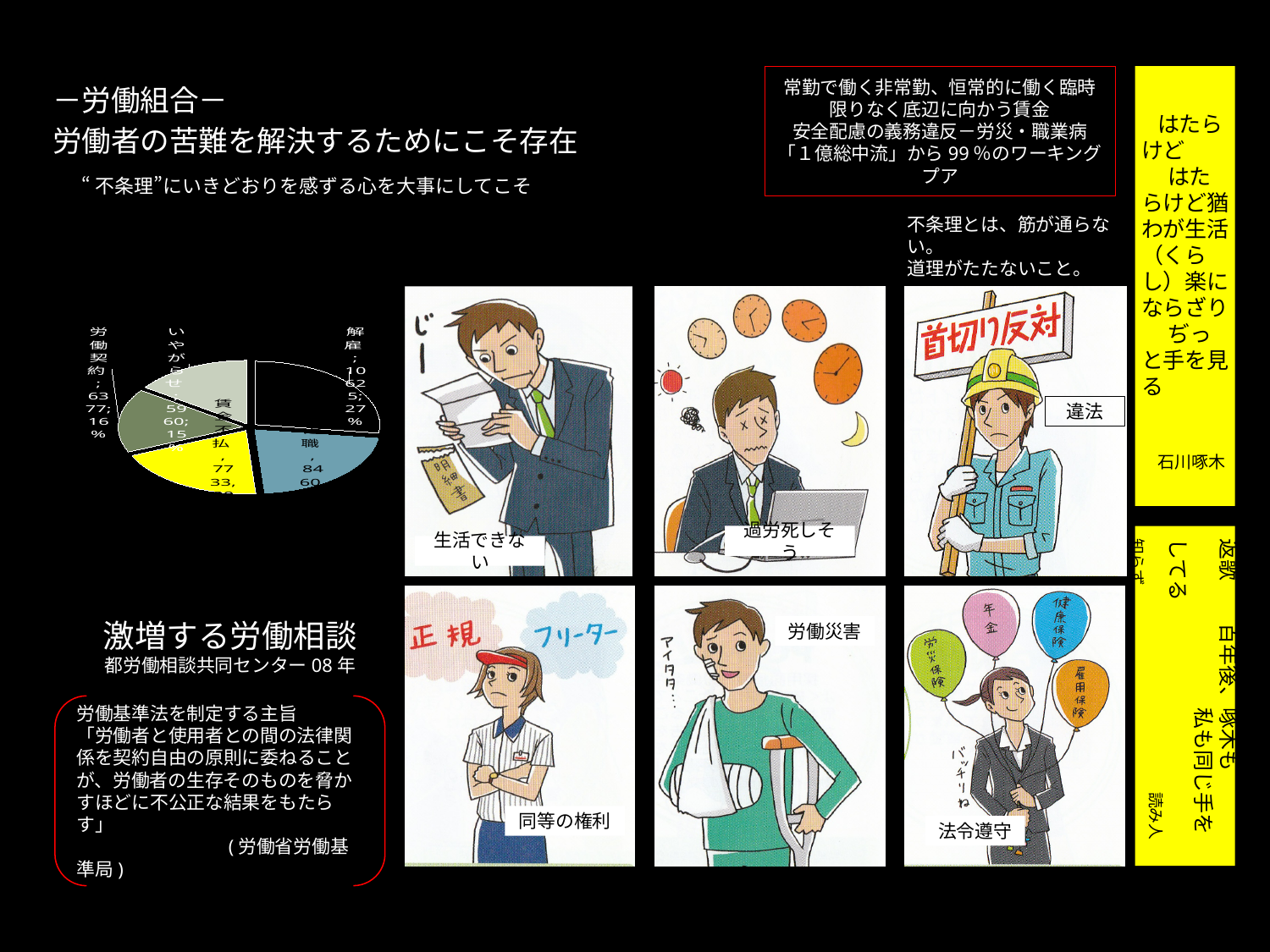
Which is larger in the pie chart, 解雇 or 労働契約? 解雇 In the pie chart, what share is labelled for 解雇? 27% In the pie chart, what share is labelled for 労働契約? 16% In the pie chart, what value is labelled for 労働契約? 6377 Which category has the largest slice in the pie chart? 解雇 What is the difference in percentage points between the 解雇 share and the 労働契約 share in the pie chart? 11 In the pie chart, what share is labelled for いやがらせ? 15% What heading appears below the pie chart? 激増する労働相談 In the pie chart, what value is labelled for いやがらせ? 5960 In the pie chart, what value is labelled for 解雇? 10625 What kind of chart is shown on the left of the slide? pie chart How many slices does the pie chart on the left have? 5